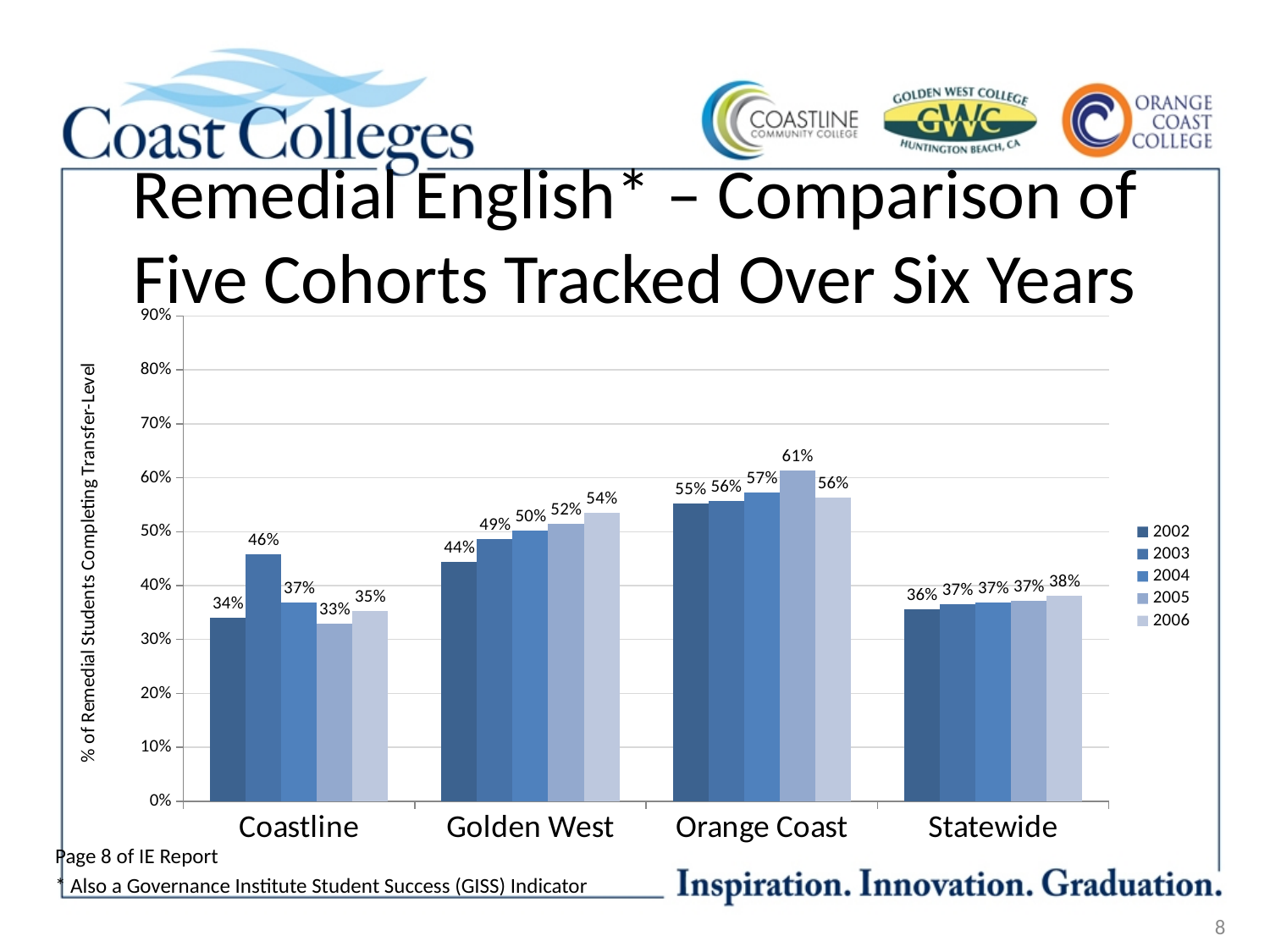
Which is larger, the 2004 value for Golden West or the 2004 value for Statewide? Golden West What is the value for Statewide in 2006? 38% What kind of chart is shown on the slide? Bar chart Do the values for Golden West rise or fall from 2002 to 2006? Rise What is the value for Golden West in 2002? 44% How many categories are shown on the x axis? 4 What is the value for Coastline in 2003? 46% What is the difference between the 2006 values for Golden West and Coastline? 19% Which category has the lowest value for 2002? Coastline Which category has the highest value for 2005? Orange Coast How many series does the legend list? 5 What is the value for Orange Coast in 2005? 61%